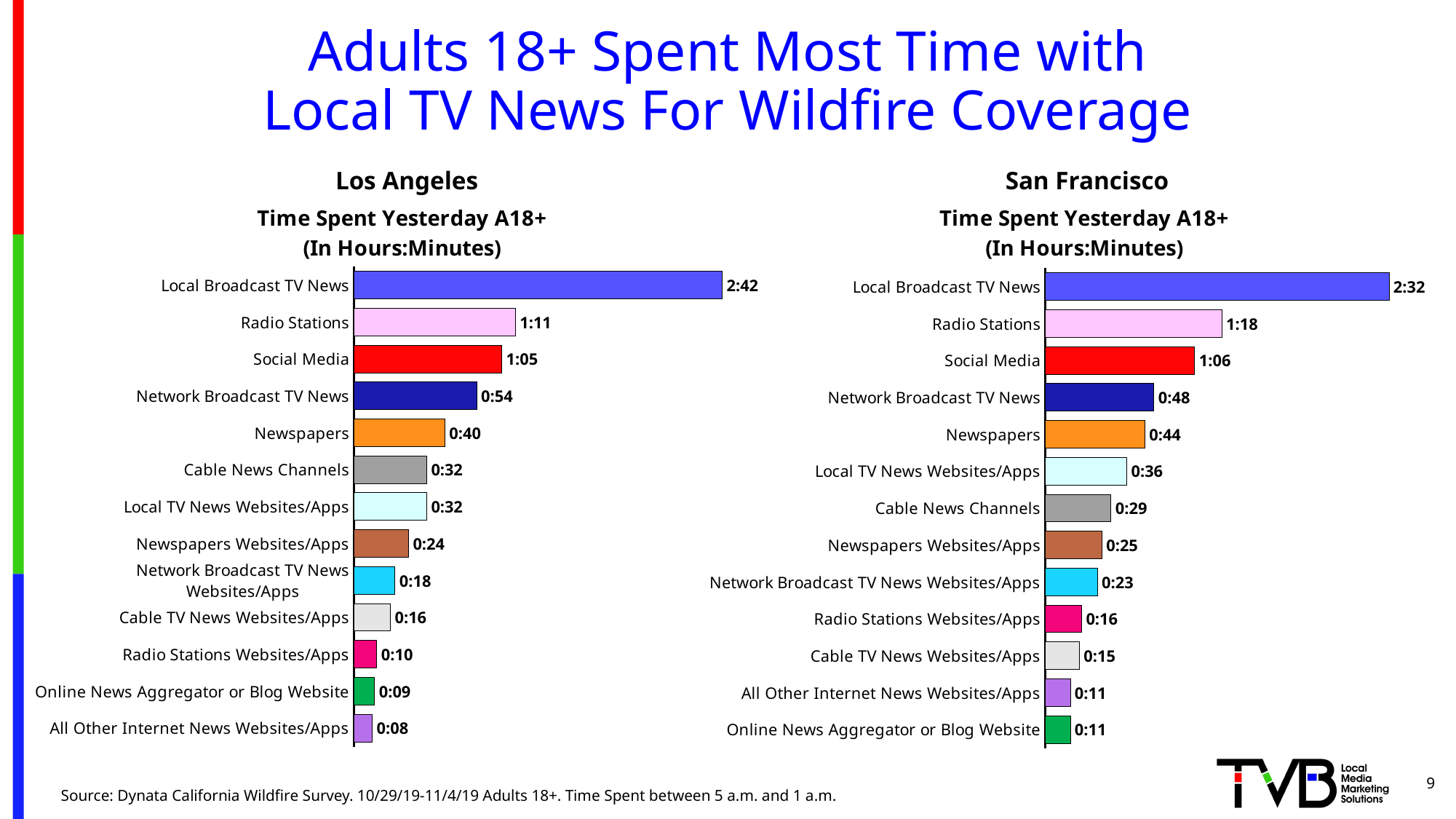
In the Los Angeles chart, which category has the highest time spent? Local Broadcast TV News In the Los Angeles chart, what is the time spent with Local Broadcast TV News? 2:42 In the Los Angeles chart, what is the time spent with Network Broadcast TV News Websites/Apps? 0:18 What type of chart is used for the San Francisco data? Bar chart In the San Francisco chart, what is the time spent with Newspapers? 0:44 In the Los Angeles chart, which category has the lowest time spent? All Other Internet News Websites/Apps In the San Francisco chart, how many minutes more were spent with Local TV News Websites/Apps than with Cable News Channels? 7 minutes In the San Francisco chart, which category has the lowest time spent? All Other Internet News Websites/Apps and Online News Aggregator or Blog Website (tied at 0:11) In the San Francisco chart, which is larger: the time spent with Social Media or with Network Broadcast TV News? Social Media How many categories are shown in the Los Angeles chart? 13 In the Los Angeles chart, how many minutes more were spent with Newspapers than with Cable News Channels? 8 minutes In the San Francisco chart, what is the time spent with Radio Stations? 1:18